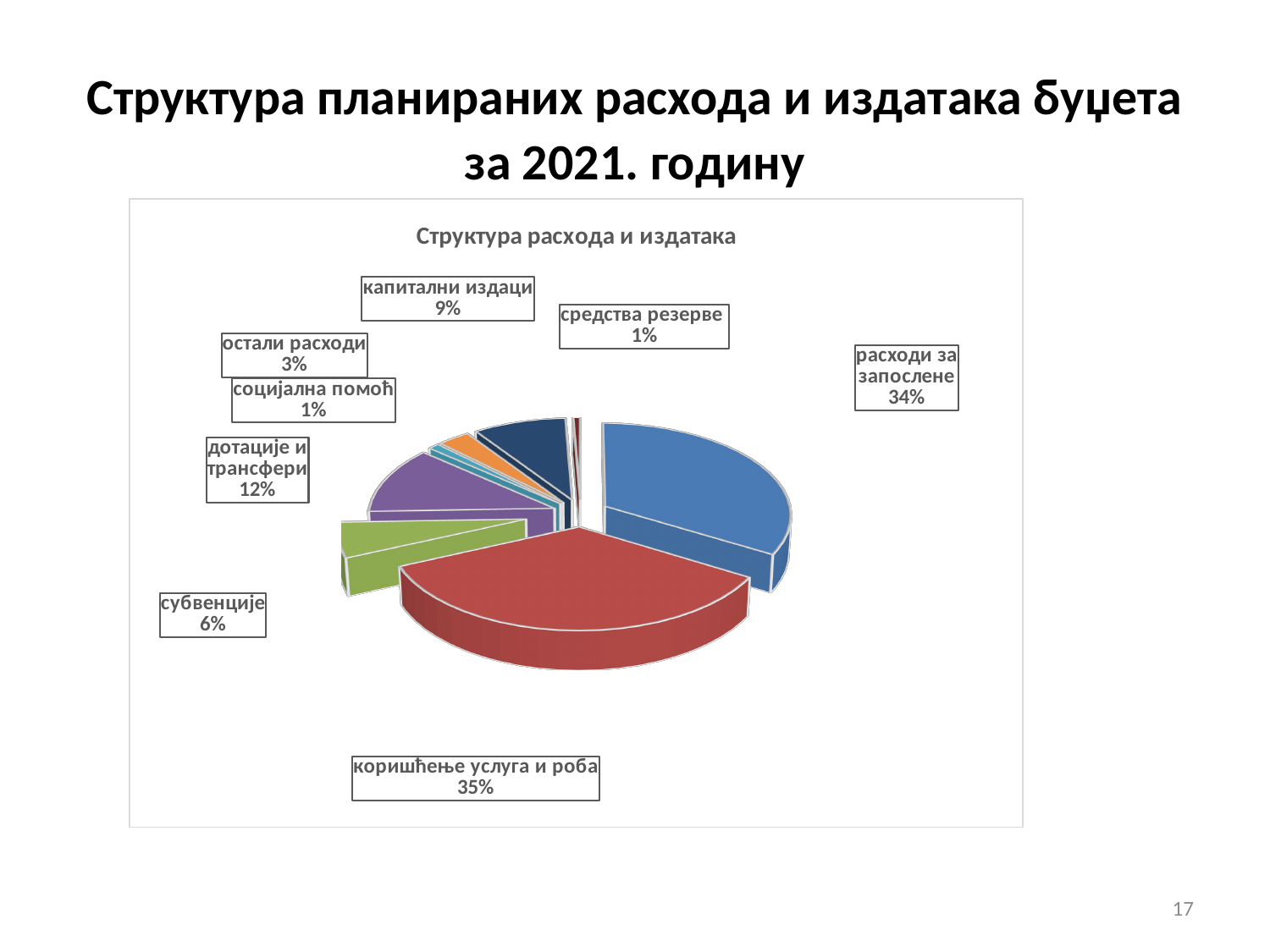
What percentage is shown for дотације и трансфери? 12% Which category has the largest share of the pie? коришћење услуга и роба What kind of chart is shown on the slide? Pie chart How many categories are shown in the pie chart? 8 Which is larger, the share for дотације и трансфери or the share for капитални издаци? дотације и трансфери What share of the pie is расходи за запослене? 34% What percentage is shown for субвенције? 6% What share of the pie is коришћење услуга и роба? 35% What percentage is shown for капитални издаци? 9% What is the difference in percentage points between расходи за запослене and дотације и трансфери? 22 What is the title of the chart? Структура расхода и издатака What percentage is shown for остали расходи? 3%